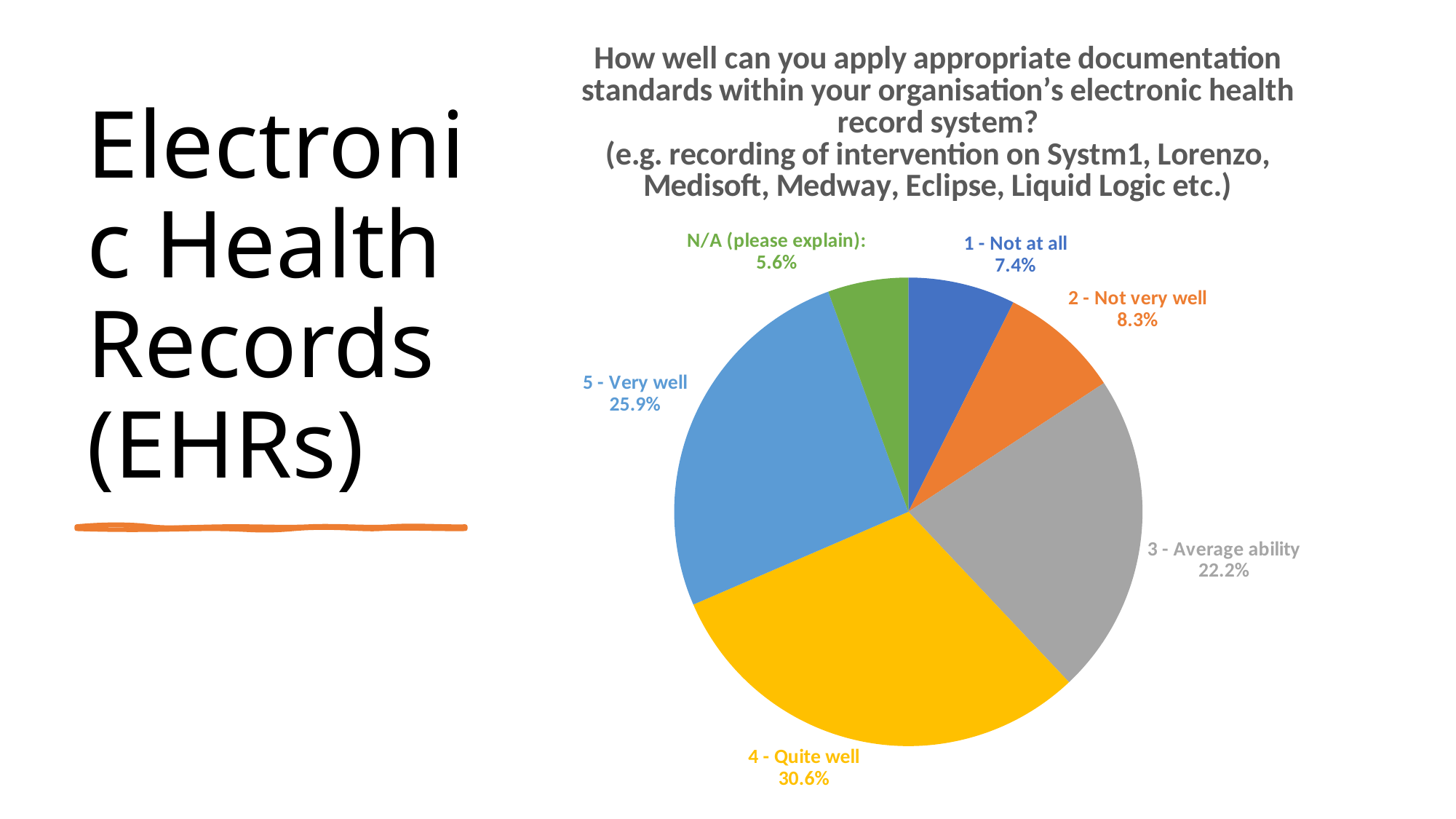
Which response category has the largest share of the pie? 4 - Quite well What colour is the slice for '4 - Quite well'? yellow What is the combined percentage of respondents who answered '4 - Quite well' or '5 - Very well'? 56.5% Which is larger, the share for '3 - Average ability' or the share for '5 - Very well'? 5 - Very well What percentage of respondents answered '3 - Average ability'? 22.2% What percentage of respondents answered '1 - Not at all'? 7.4% What percentage of respondents answered 'N/A (please explain)'? 5.6% Which response category has the smallest share of the pie? N/A (please explain) What kind of chart is shown on the slide? pie chart What percentage of respondents answered '4 - Quite well'? 30.6% What is the difference in percentage points between '5 - Very well' and '2 - Not very well'? 17.6 How many categories are shown in the pie chart? 6